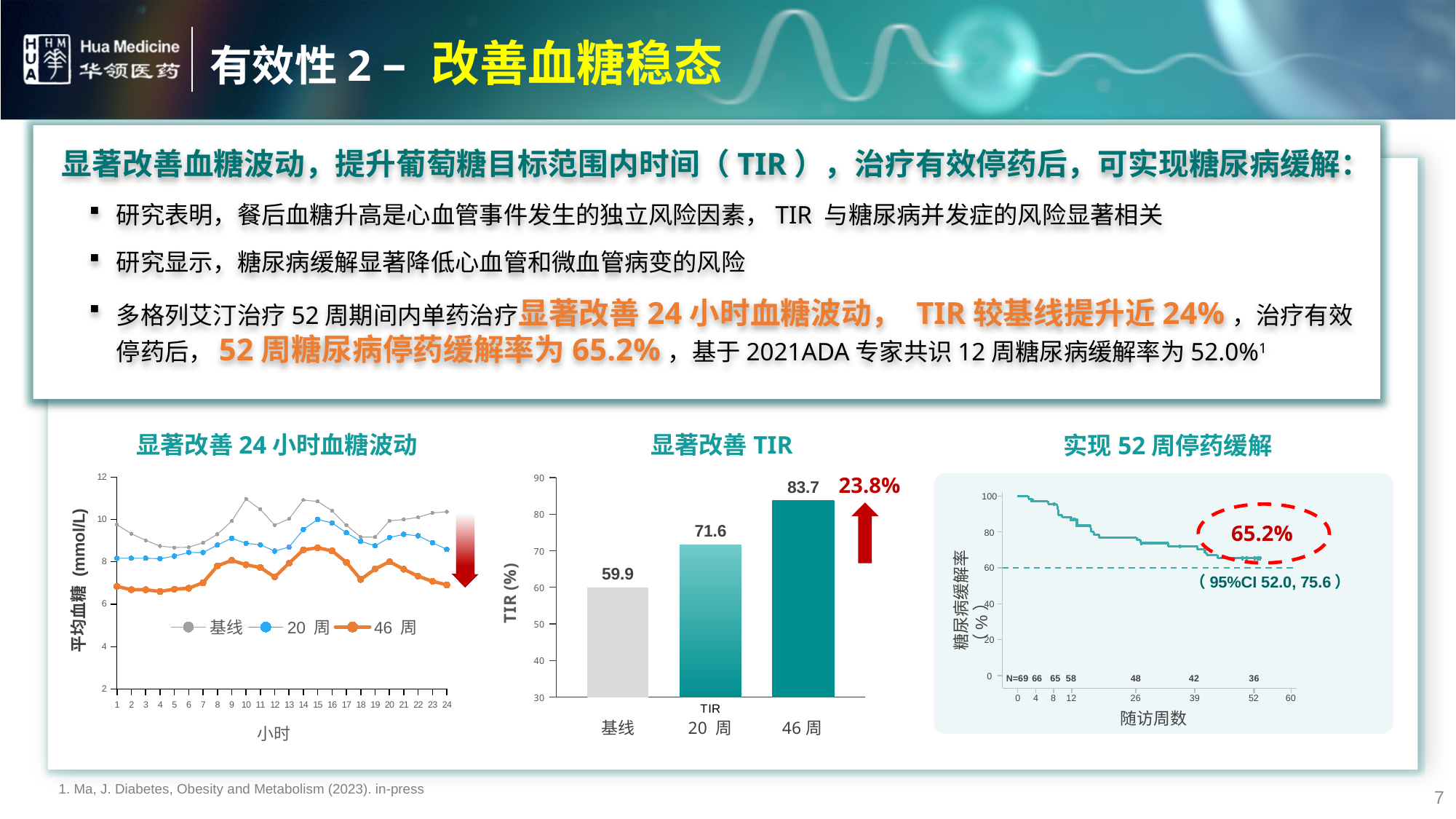
In the chart titled 显著改善 TIR, do the values rise or fall from 基线 to 46 周? rise In the chart titled 显著改善 TIR, what is the difference between the 46 周 value and the 基线 value? 23.8 In the chart titled 显著改善 TIR, which category has the highest TIR value? 46 周 In the chart titled 实现 52 周停药缓解, what remission rate is highlighted in the dashed circle? 65.2% In the chart titled 显著改善 TIR, what is the TIR value for 46 周? 83.7 In the chart titled 显著改善 TIR, what is the TIR value for 20 周? 71.6 In the chart titled 显著改善 24 小时血糖波动, is the 46 周 value at hour 1 greater or less than 8? less In the chart titled 显著改善 TIR, what kind of chart is shown? bar chart In the chart titled 显著改善 24 小时血糖波动, how many series does the legend list? 3 In the chart titled 显著改善 24 小时血糖波动, how many hour points are shown on the x axis? 24 In the chart titled 显著改善 TIR, what is the TIR value for 基线? 59.9 In the chart titled 显著改善 TIR, which category has the lowest TIR value? 基线